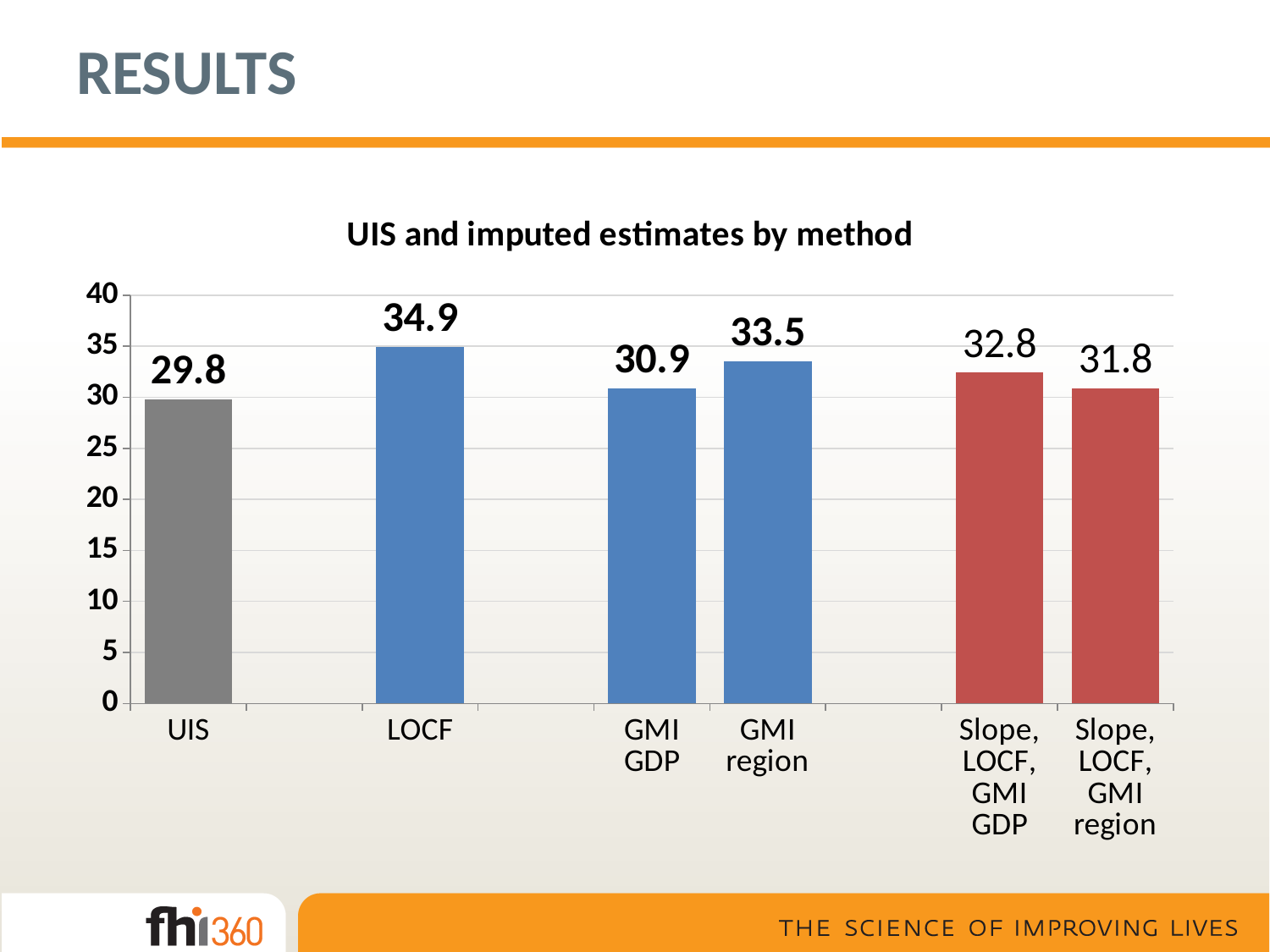
What is the title of the chart? UIS and imputed estimates by method What is the difference between the LOCF value and the UIS value? 5.1 What is the value for Slope, LOCF, GMI GDP? 32.8 What is the value for UIS? 29.8 What is the value for GMI region? 33.5 Which method has the highest value? LOCF How many bars are shown in the chart? 6 Which is larger, the value for Slope, LOCF, GMI GDP or the value for Slope, LOCF, GMI region? Slope, LOCF, GMI GDP Which category has the lowest value? UIS What is the value for LOCF? 34.9 What is the difference between the GMI region value and the GMI GDP value? 2.6 What kind of chart is shown on the slide? Bar chart